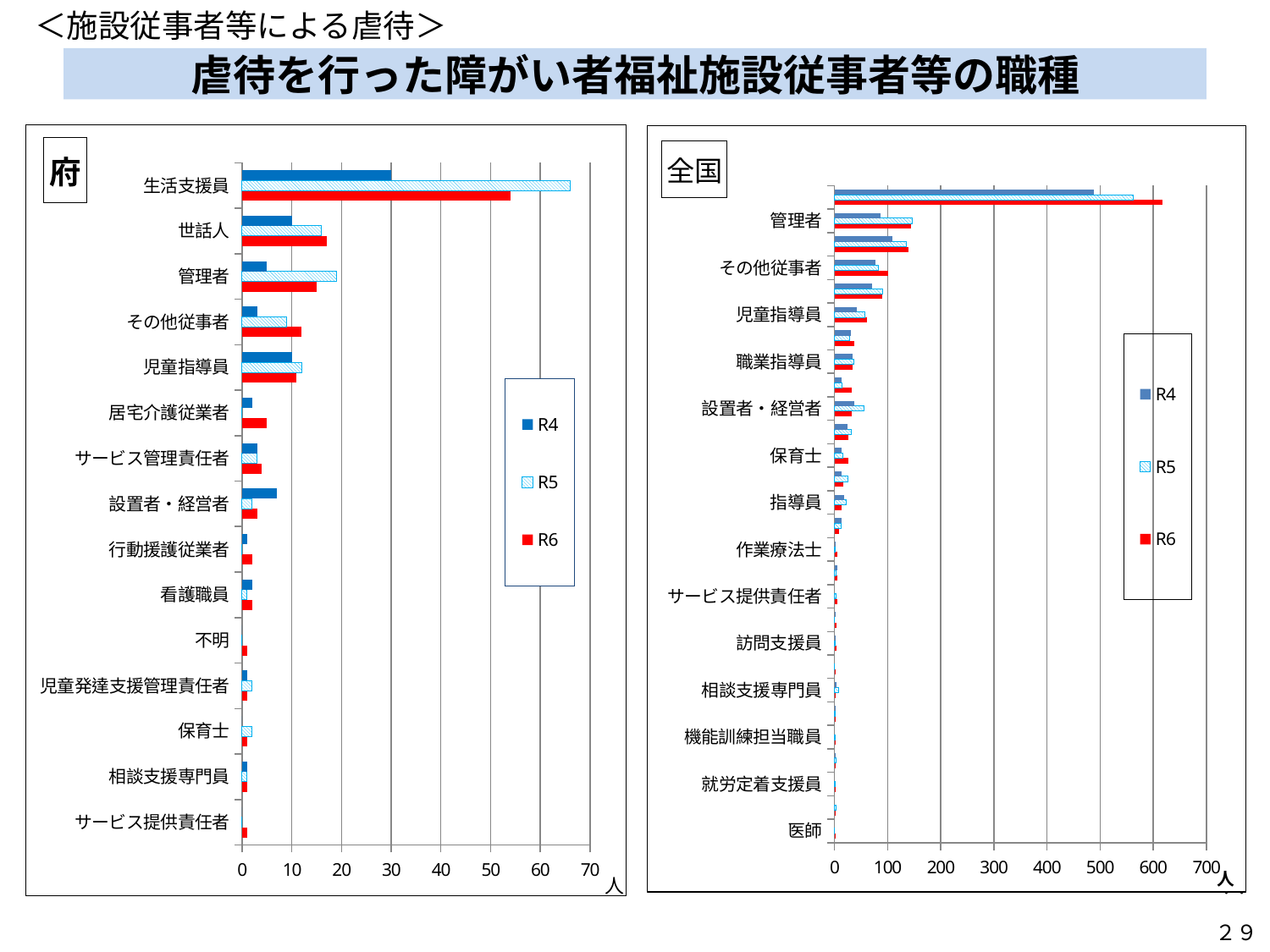
How many job categories are shown on the 府 chart? 15 In the 府 chart, is the R4 value for 設置者・経営者 greater or less than 10? less In the 府 chart, which is larger for 設置者・経営者, the R4 value or the R6 value? R4 In the 府 chart, which year has the highest value for 生活支援員? R5 How many series does the legend of the 府 chart list? 3 What are the legend entries of the 全国 chart? R4, R5, R6 In the 府 chart, which category has the longest R5 bar? 生活支援員 In the 府 chart, is the R5 value for 管理者 greater or less than 10? greater In the 府 chart, is the R6 value for 生活支援員 greater or less than 50? greater What is the maximum value shown on the x axis of the 全国 chart? 700 What kind of chart is the 府 chart on the left? bar chart